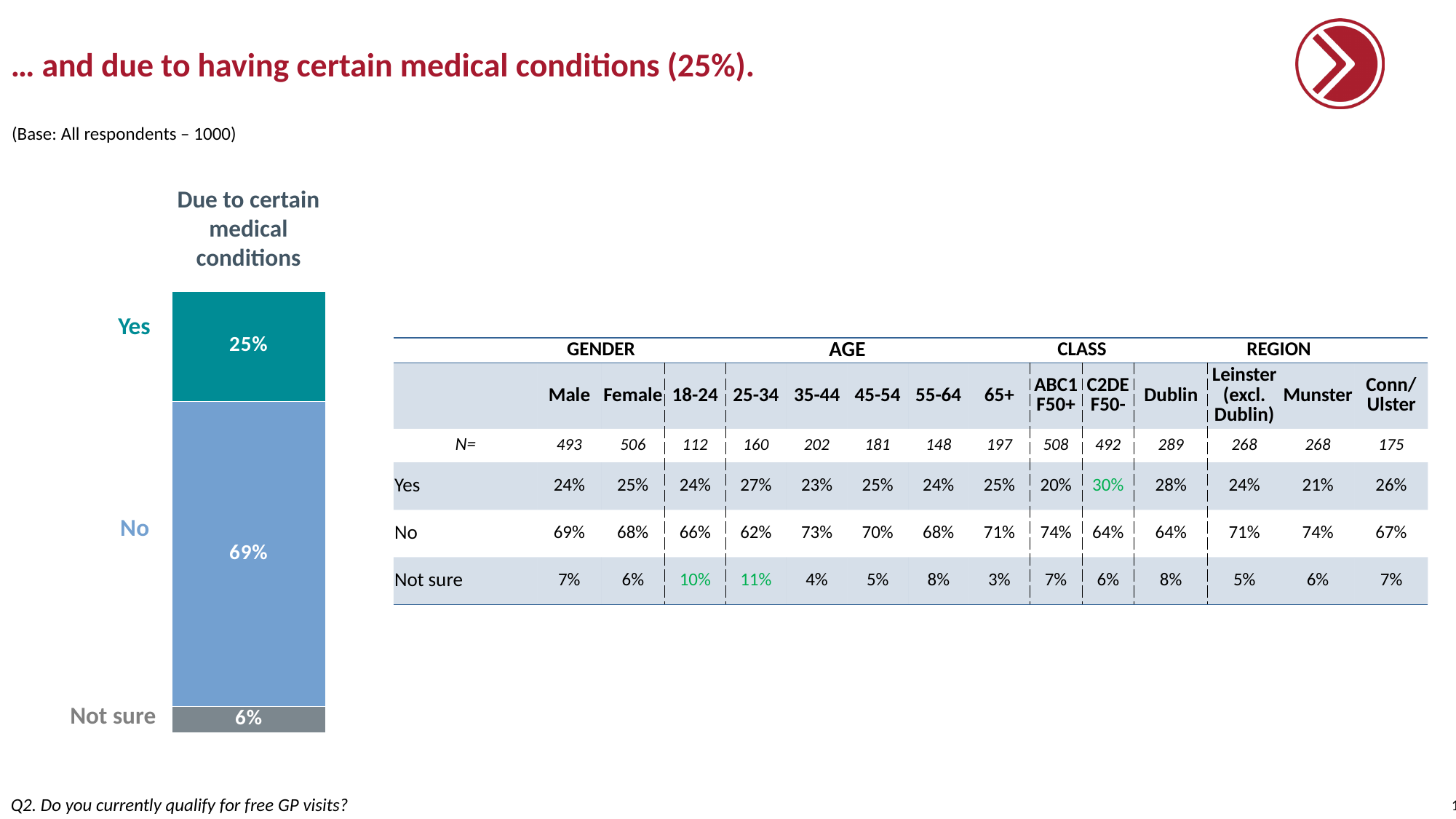
In the "Due to certain medical conditions" bar chart, what is the difference between the "No" and "Yes" percentages? 44% What percentage of respondents answered "Not sure" in the "Due to certain medical conditions" bar chart? 6% What is the total of all segments in the "Due to certain medical conditions" stacked bar? 100% What percentage of respondents answered "No" in the "Due to certain medical conditions" bar chart? 69% Which response has the smallest segment in the "Due to certain medical conditions" bar chart? Not sure What percentage of respondents answered "Yes" in the "Due to certain medical conditions" bar chart? 25% What colour is the "Yes" segment in the "Due to certain medical conditions" bar chart? Teal Which response has the largest segment in the "Due to certain medical conditions" bar chart? No How many response categories are shown in the "Due to certain medical conditions" bar chart? 3 What type of chart is used to show the "Due to certain medical conditions" responses? Stacked bar chart In the "Due to certain medical conditions" bar chart, what is the difference between the "Yes" and "Not sure" percentages? 19% In the "Due to certain medical conditions" bar chart, which is larger: the "Yes" segment or the "Not sure" segment? Yes